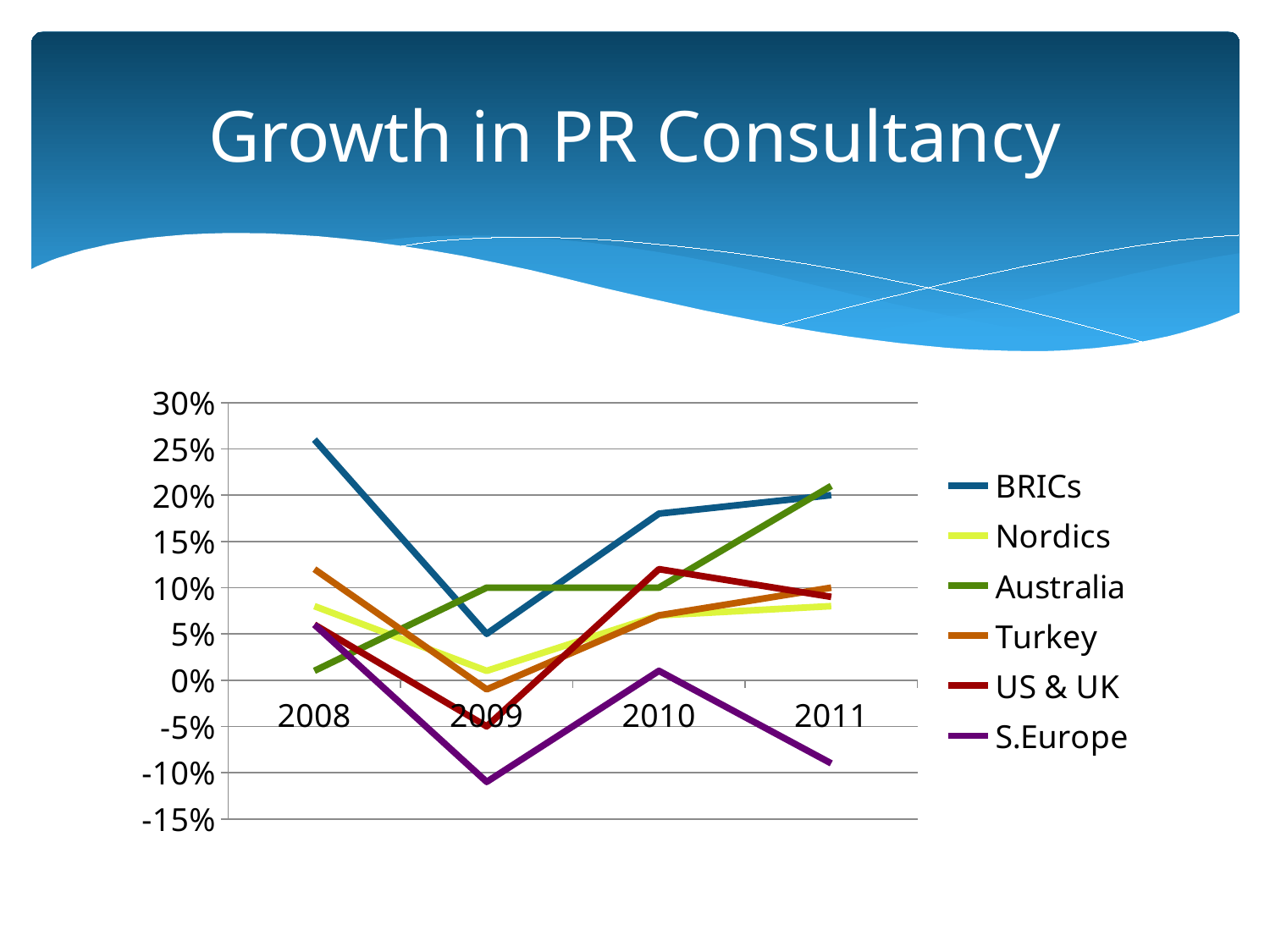
How many years are shown on the x axis? 4 Which series had the highest growth in 2008? BRICs What is the title of the chart? Growth in PR Consultancy Which series had the lowest growth in 2009? S.Europe Is the value for US & UK in 2009 greater or less than 0%? less Is the value for S.Europe in 2009 greater or less than -5%? less How many series does the legend list? 6 Which series had the lowest growth in 2011? S.Europe Does the S.Europe line rise or fall from 2010 to 2011? fall Is the value for BRICs in 2008 greater or less than 20%? greater What kind of chart is shown on the slide? line chart Which is larger in 2010, the value for BRICs or the value for S.Europe? BRICs